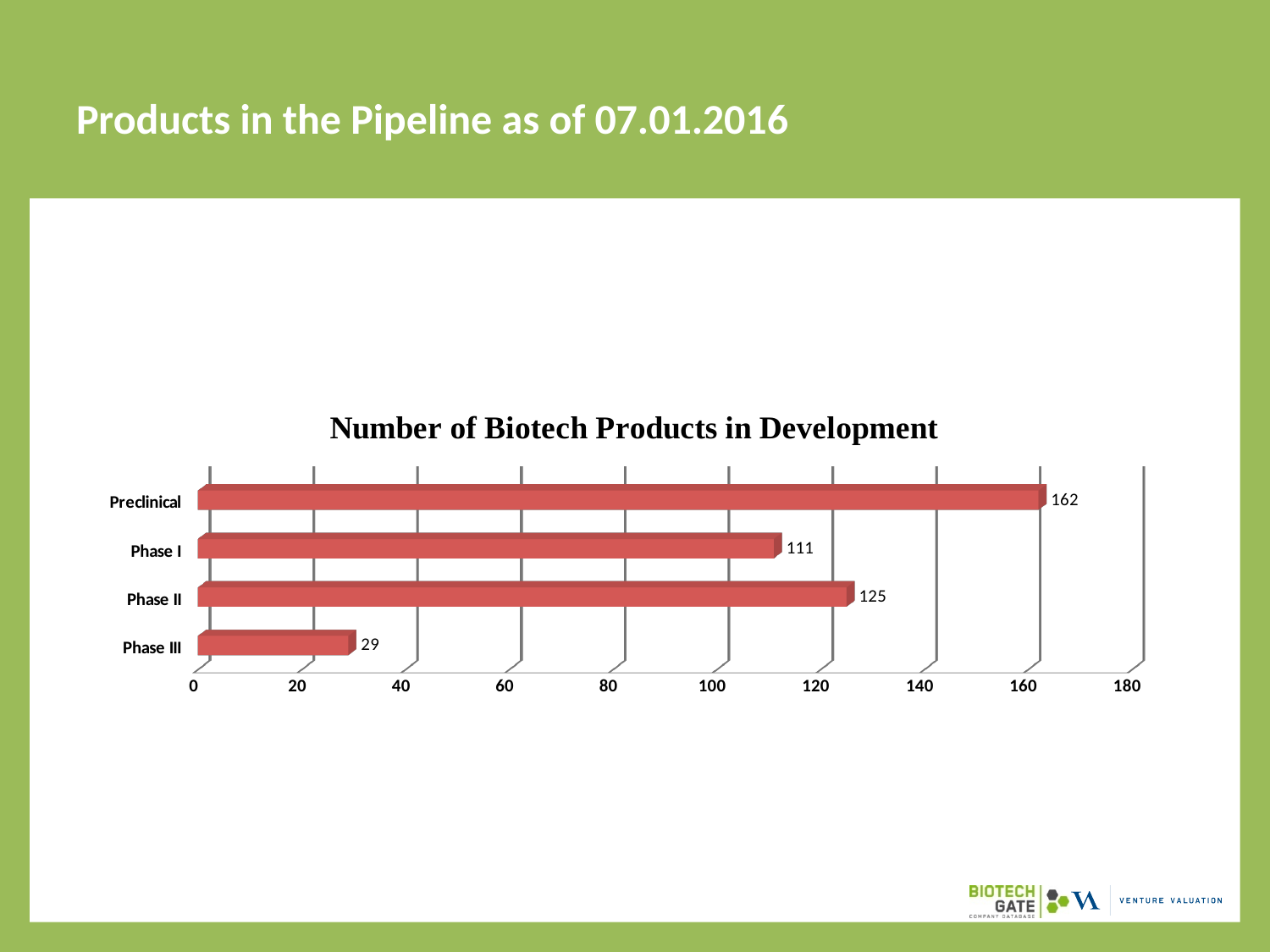
What is the difference between the Phase II and Phase I values? 14 Which is larger, the value for Phase I or the value for Phase II? Phase II How many categories are shown in the chart? 4 What is the difference between the Preclinical and Phase III values? 133 What is the number of biotech products in development at the Preclinical stage? 162 What is the value for Phase III? 29 What kind of chart is shown on the slide? Bar chart What is the title of the chart? Number of Biotech Products in Development What is the value for Phase I? 111 Which category has the highest number of products in development? Preclinical Which category has the lowest number of products in development? Phase III What is the value for Phase II? 125